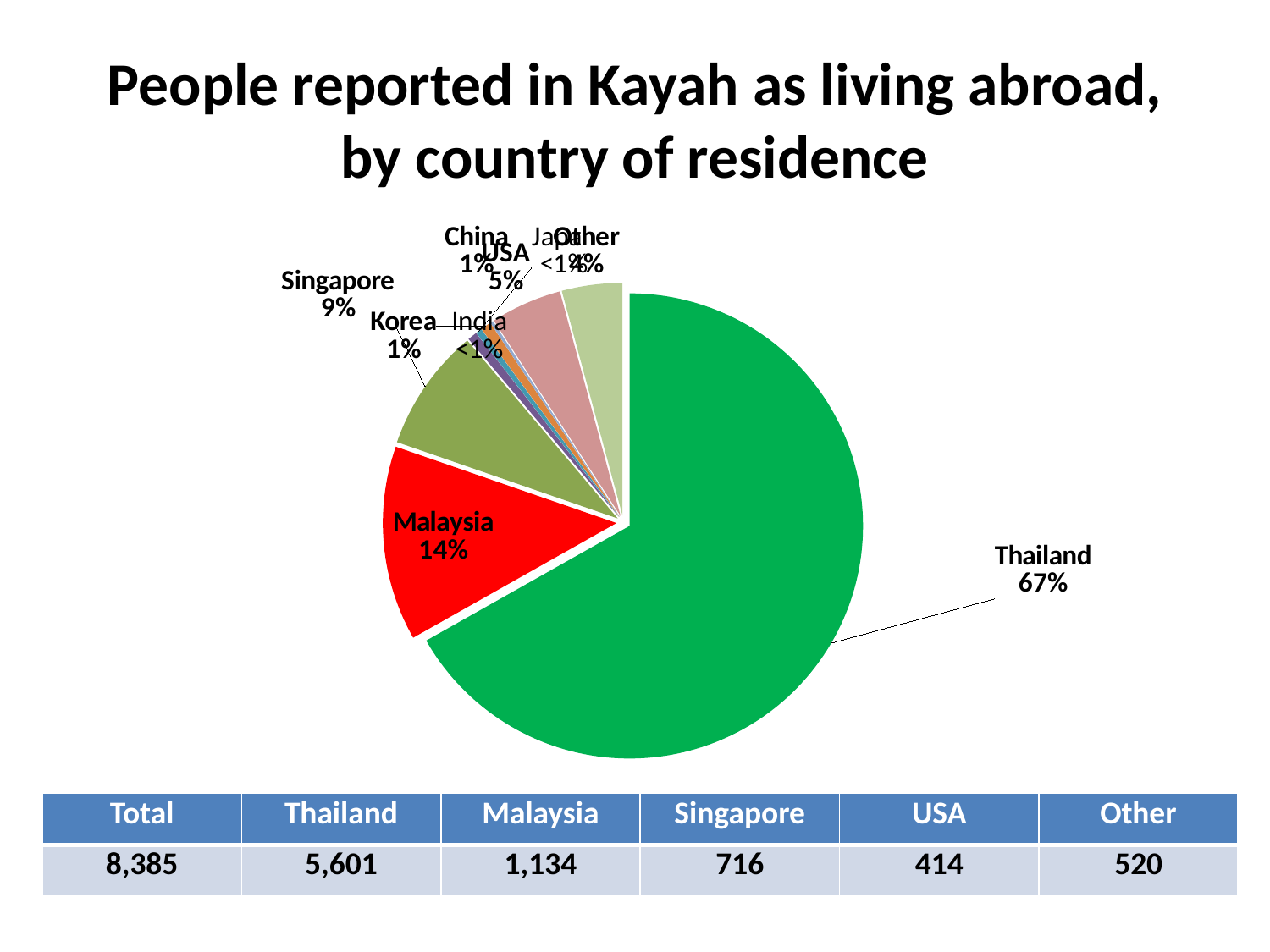
Which country has the largest slice of the pie? Thailand What share of the pie does Thailand account for? 67% What share of the pie does the USA account for? 5% According to the table below the chart, what is the total number of people reported as living abroad? 8,385 What share of the pie does Singapore account for? 9% According to the table below the chart, how many people were reported as living in Thailand? 5,601 What type of chart is shown on the slide? pie chart What is the difference in percentage points between the Thailand and Malaysia slices? 53 Which slice is larger, Malaysia or Singapore? Malaysia What is the title of the chart? People reported in Kayah as living abroad, by country of residence